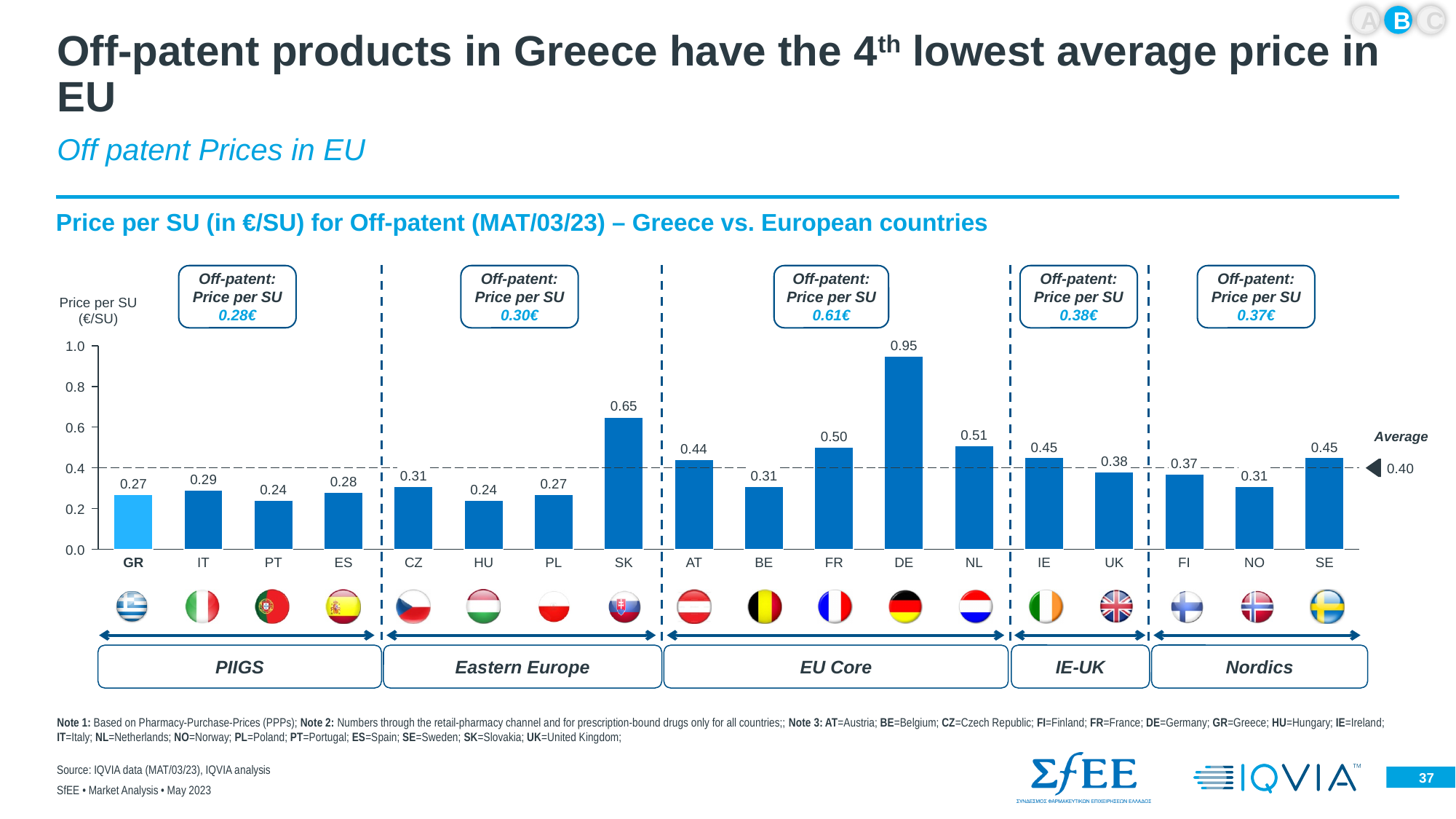
What kind of chart is shown on the slide? Bar chart How many countries are shown on the chart? 18 What is the off-patent price per SU shown for the EU Core group? 0.61€ What is the difference in price per SU between Slovakia (SK) and Poland (PL)? 0.38 What is the price per SU for Germany (DE)? 0.95 How many country groups are labelled below the chart? 5 Which country has the highest price per SU? DE Which has a higher price per SU, France (FR) or the Netherlands (NL)? NL What is the difference in price per SU between Sweden (SE) and Norway (NO)? 0.14 Is the value for Austria (AT) greater or less than 0.4? greater What is the price per SU for Greece (GR)? 0.27 What is the average price per SU marked by the dashed line? 0.40